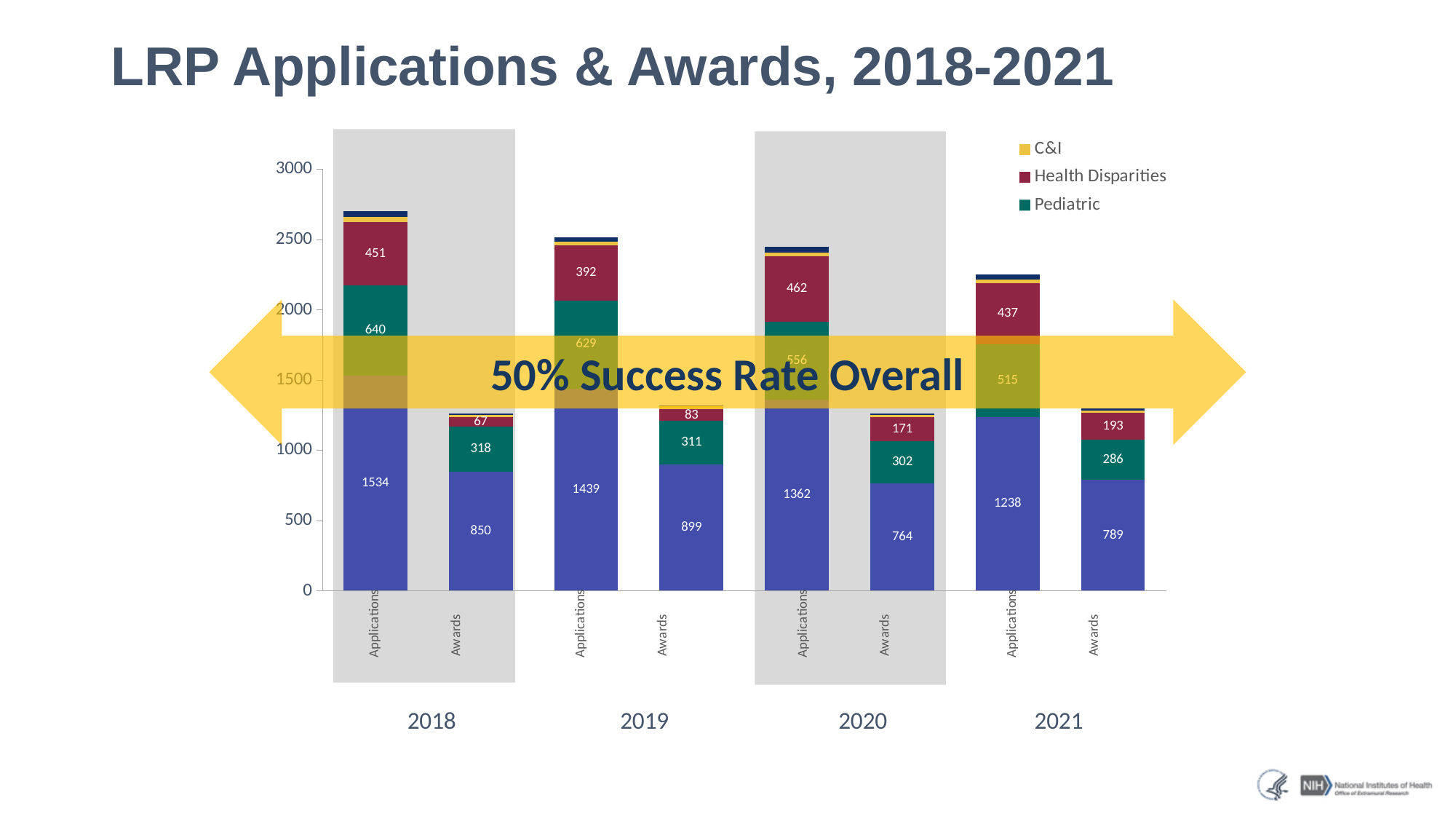
What is the Pediatric value for the 2018 Applications bar? 640 In which year is the Health Disparities value for Awards the lowest? 2018 How many bars are plotted in the chart? 8 In which year is the Pediatric value for Applications the highest? 2018 What is the difference between the Pediatric value for 2018 Applications and the Pediatric value for 2021 Applications? 125 What is the Pediatric value for the 2019 Awards bar? 311 What is the Health Disparities value for the 2021 Applications bar? 437 What kind of chart is shown on the slide? Stacked bar chart Which is larger: the Health Disparities value for 2020 Applications or for 2019 Applications? 2020 Applications How many series does the legend list? 3 Is the total height of the 2018 Applications bar greater or less than 2500? greater What is the Health Disparities value for the 2020 Awards bar? 171